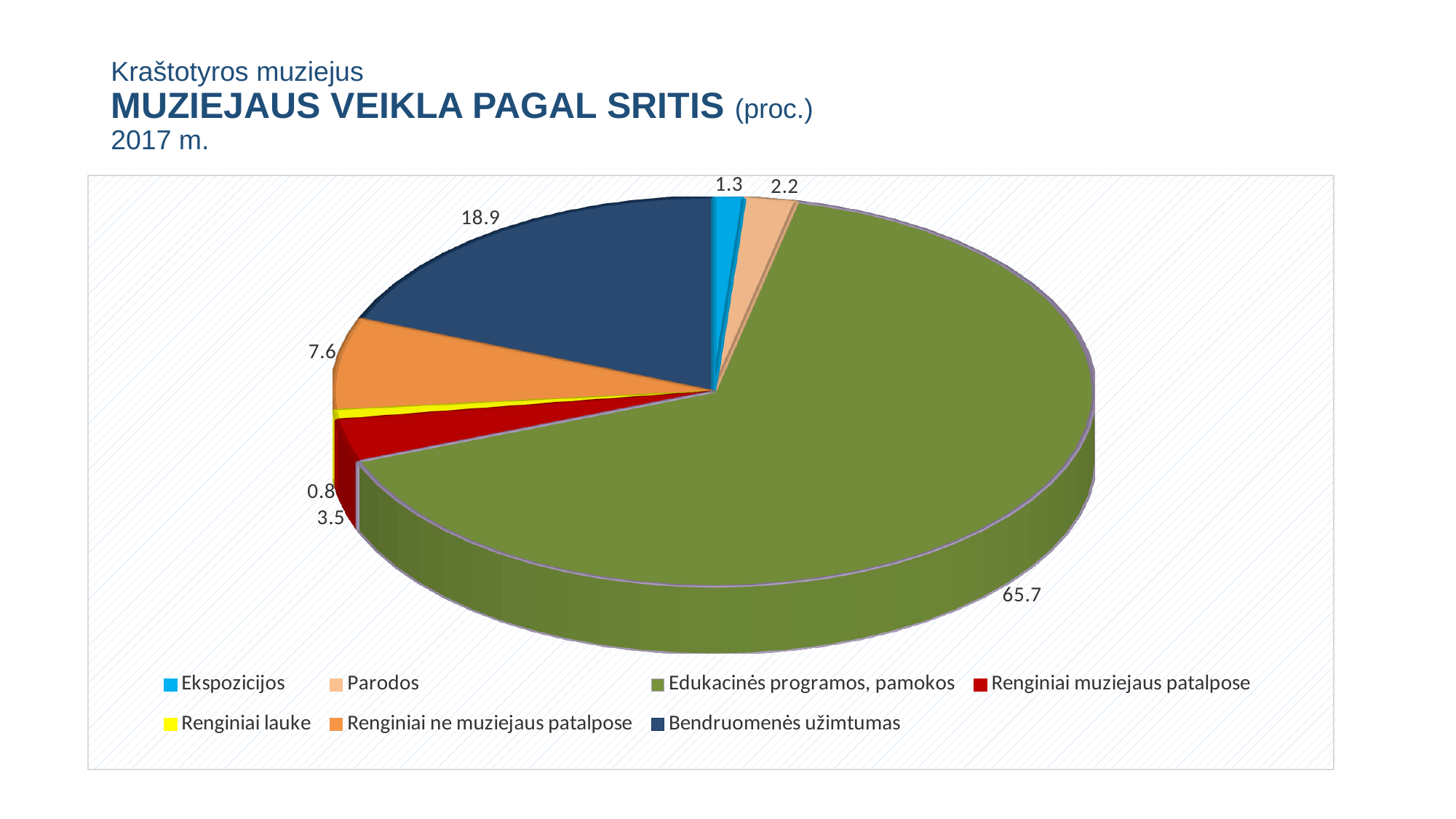
What is the difference between the values for Bendruomenės užimtumas and Renginiai ne muziejaus patalpose? 11.3 What is the value for Renginiai ne muziejaus patalpose? 7.6 What is the value for Edukacinės programos, pamokos? 65.7 What is the value for Parodos? 2.2 What colour is the slice for Ekspozicijos? light blue Which is larger, Renginiai muziejaus patalpose or Parodos? Renginiai muziejaus patalpose What kind of chart is shown on the slide? pie chart What is the value for Renginiai lauke? 0.8 What is the value for Bendruomenės užimtumas? 18.9 How many categories does the pie chart have? 7 Which category has the largest share of the pie? Edukacinės programos, pamokos Which category has the smallest share of the pie? Renginiai lauke